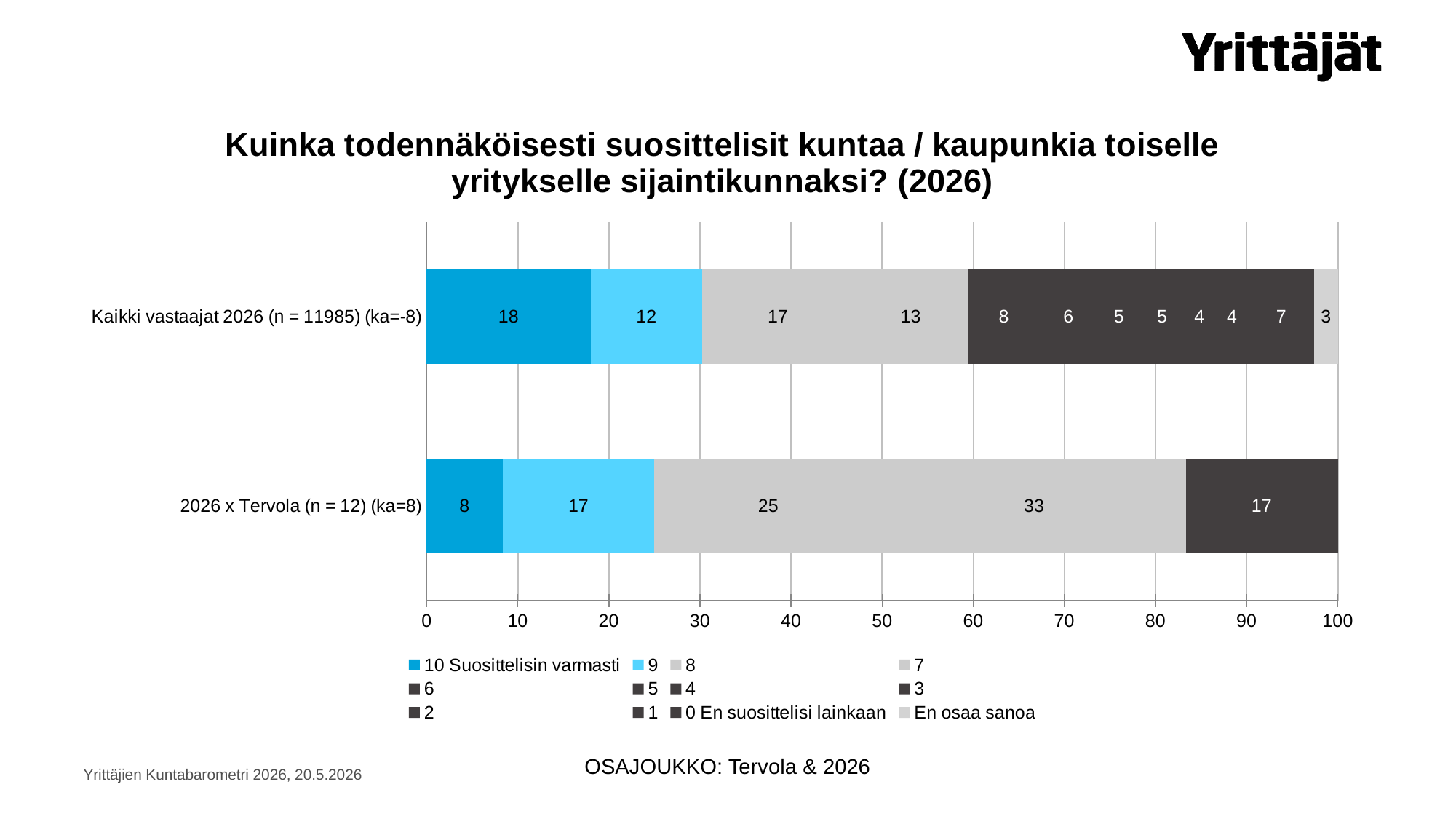
How many respondent groups (bars) are shown in the chart? 2 What is the title of the chart? Kuinka todennäköisesti suosittelisit kuntaa / kaupunkia toiselle yritykselle sijaintikunnaksi? (2026) What is the largest segment value in the "2026 x Tervola (n = 12) (ka=8)" bar? 33 What is the value of the "10 Suosittelisin varmasti" segment for "Kaikki vastaajat 2026 (n = 11985) (ka=-8)"? 18 What is the total of all segments in the "2026 x Tervola (n = 12) (ka=8)" bar? 100 What is the value of the "8" segment for "2026 x Tervola (n = 12) (ka=8)"? 25 What is the value of the "9" segment for "2026 x Tervola (n = 12) (ka=8)"? 17 What is the value of the "En osaa sanoa" segment for "Kaikki vastaajat 2026 (n = 11985) (ka=-8)"? 3 What kind of chart is shown on the slide? Stacked bar chart What is the difference between the "7" segment for "2026 x Tervola" (33) and for "Kaikki vastaajat 2026" (13)? 20 Which group has the larger "10 Suosittelisin varmasti" segment, "Kaikki vastaajat 2026" or "2026 x Tervola"? Kaikki vastaajat 2026 How many series does the legend list? 12